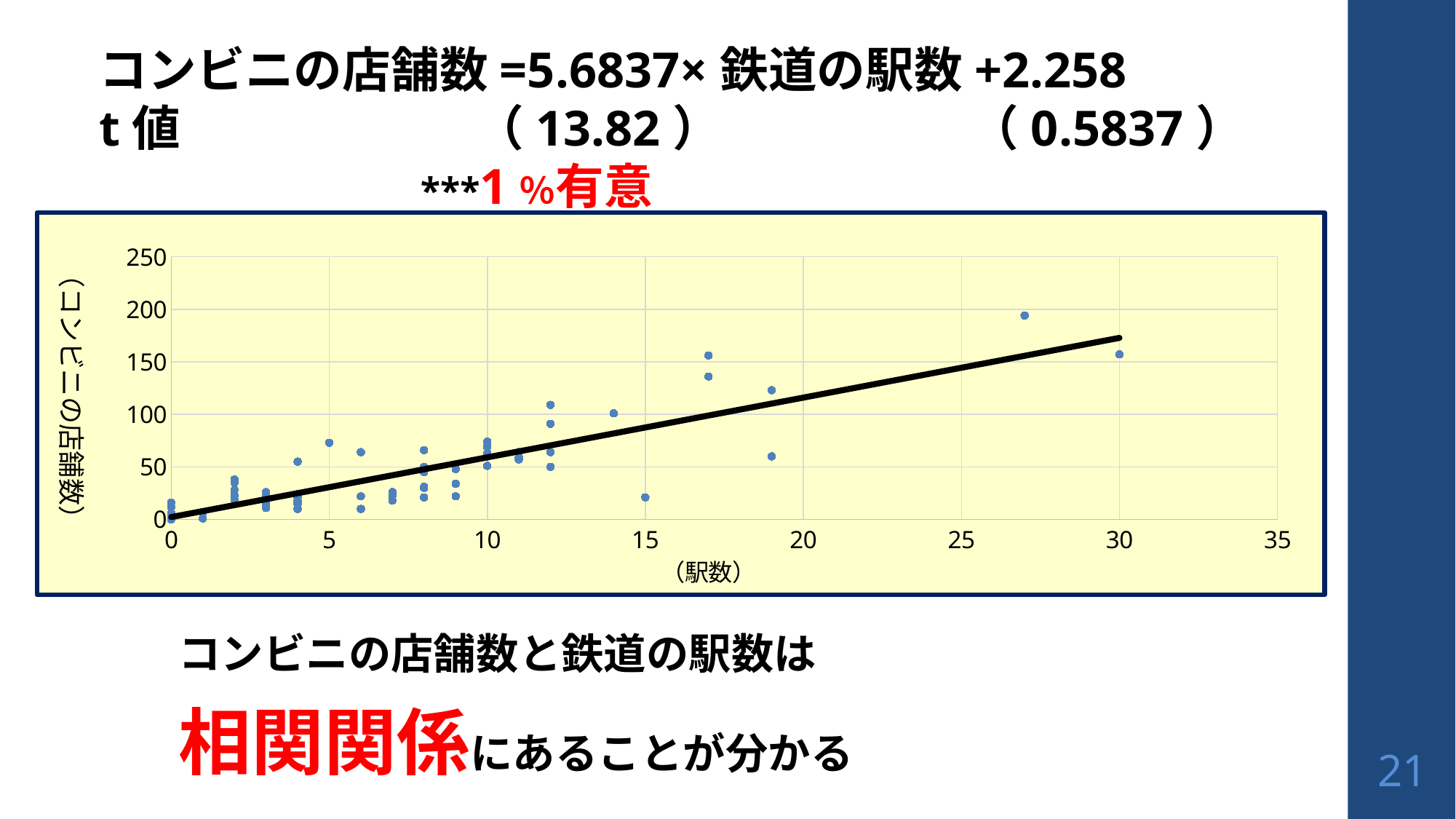
Which point has the highest y value: the one at 27 stations or the one at 15 stations? 27 stations What is the highest tick value shown on the y axis? 250 What kind of chart is shown on the slide? scatter chart Do the plotted values generally rise or fall as the number of stations (駅数) increases along the x axis? rise What is the label of the x axis of the chart? （駅数） Is the value for the point at 5 stations greater or less than 100? less What is the label of the y axis of the chart? （コンビニの店舗数） Is the value for the point at 27 stations greater or less than 150? greater Does the trend line slope upward or downward from left to right? upward Is the value for the point at 5 stations greater or less than 50? greater